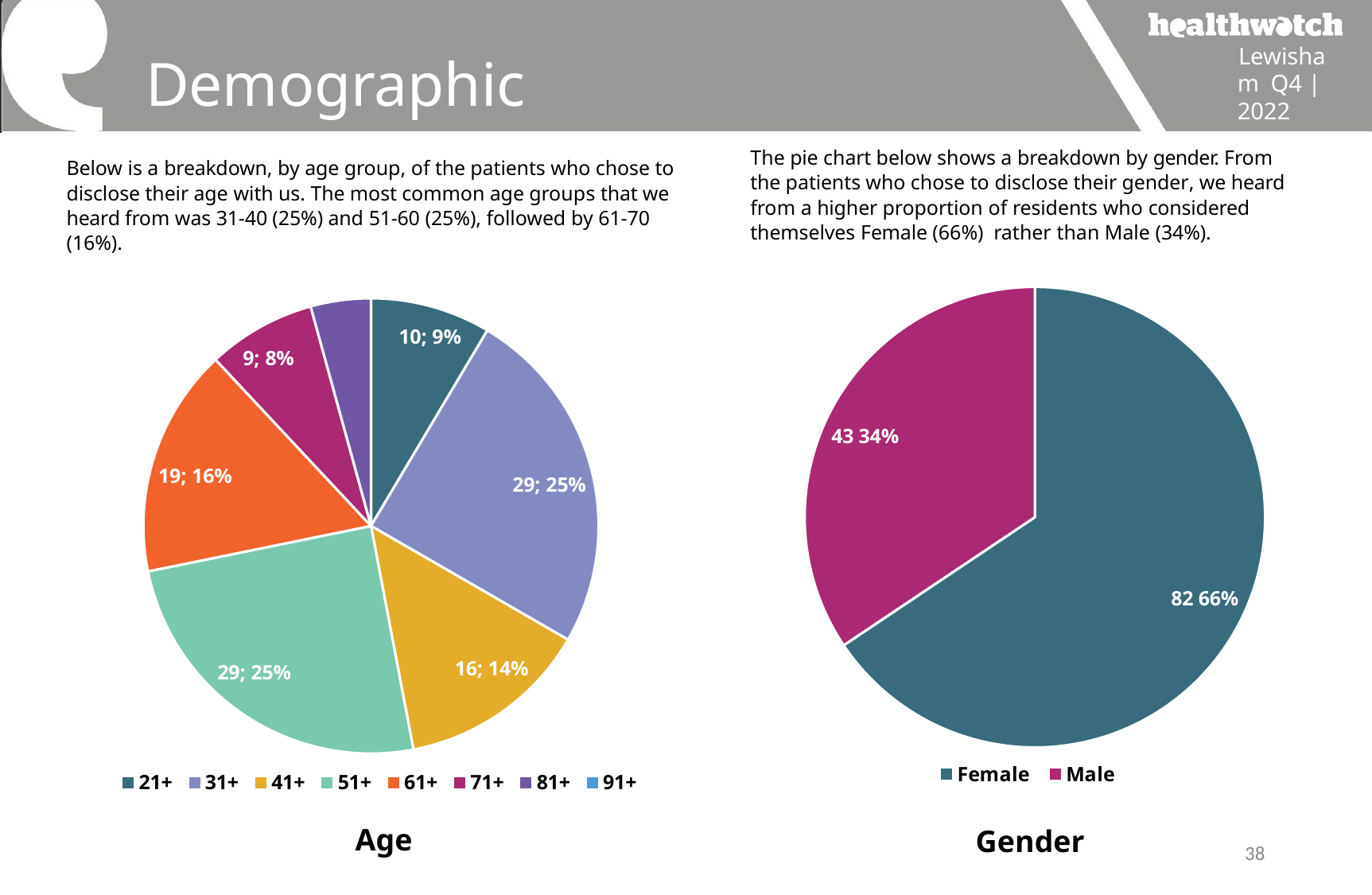
In the Age chart, what value is shown for the 61+ slice? 19; 16% In the Gender chart, what is the difference between the Female count and the Male count? 39 How many entries does the legend of the Age chart list? 8 In the Age chart, what value is shown for the 31+ slice? 29; 25% In the Age chart, which is larger, the 61+ slice or the 41+ slice? 61+ In the Gender chart, what share of the pie does Male represent? 34% In the Age chart, what value is shown for the 21+ slice? 10; 9% In the Age chart, what is the difference between the 61+ count and the 71+ count? 10 In the Gender chart, what value is shown for Female? 82 66% What kind of chart is the Age chart? pie chart In the Age chart, what share of the pie does the 41+ slice represent? 14% In the Age chart, what share of the pie does the 71+ slice represent? 8%